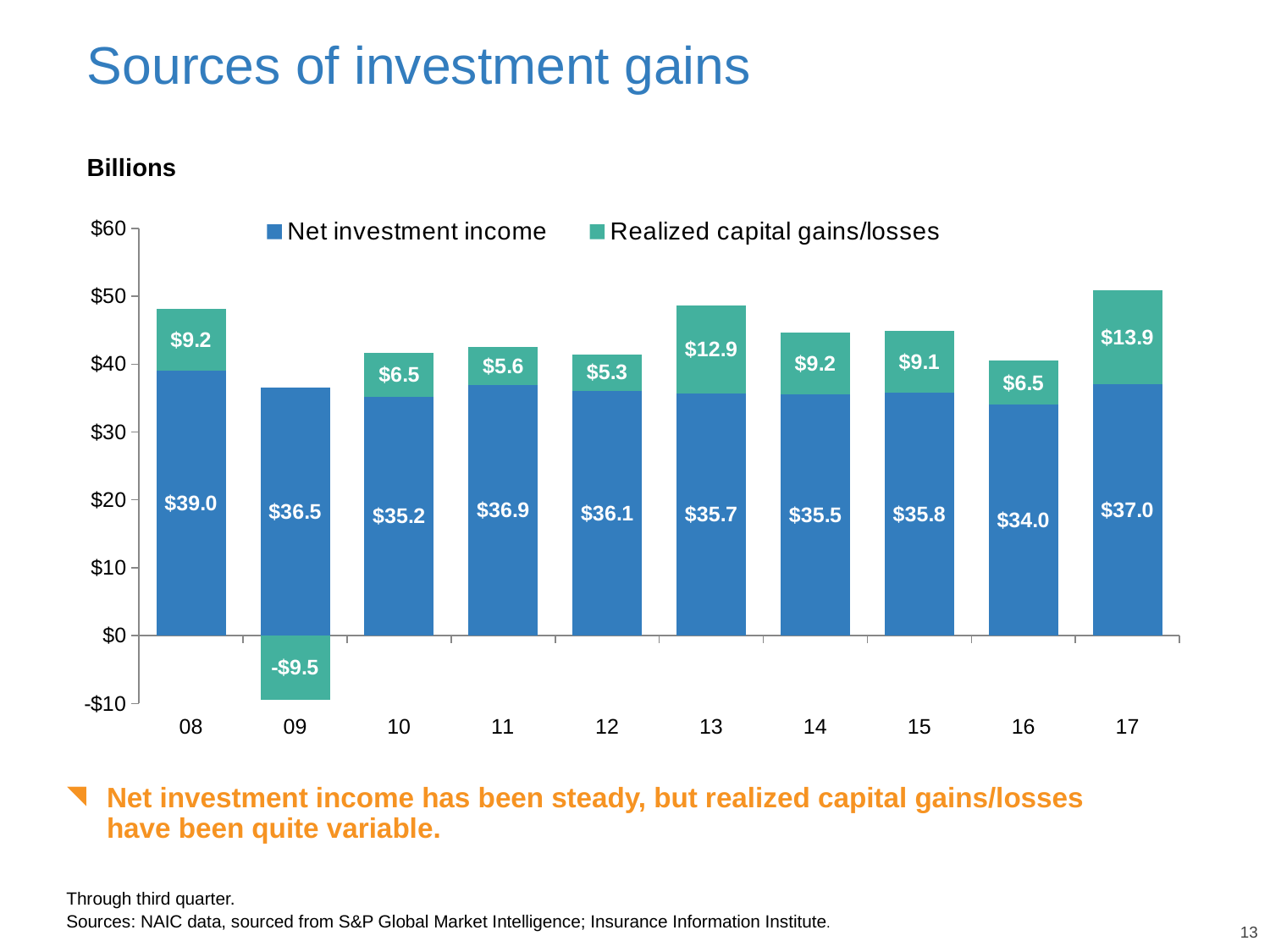
Which year has the lowest net investment income? 16 What is the total of the stacked bar for 17? $50.9 What is the difference between net investment income in 17 and in 16? $3.0 What is the realized capital gains/losses value for 09? -$9.5 Which year has the highest net investment income? 08 Which year has the highest realized capital gains/losses? 17 How many series does the legend list? 2 How many years are shown on the x axis? 10 What is the net investment income for 08? $39.0 Which is larger, realized capital gains/losses in 13 or in 14? 13 What kind of chart is shown on the slide? Stacked bar chart What is the realized capital gains/losses value for 17? $13.9